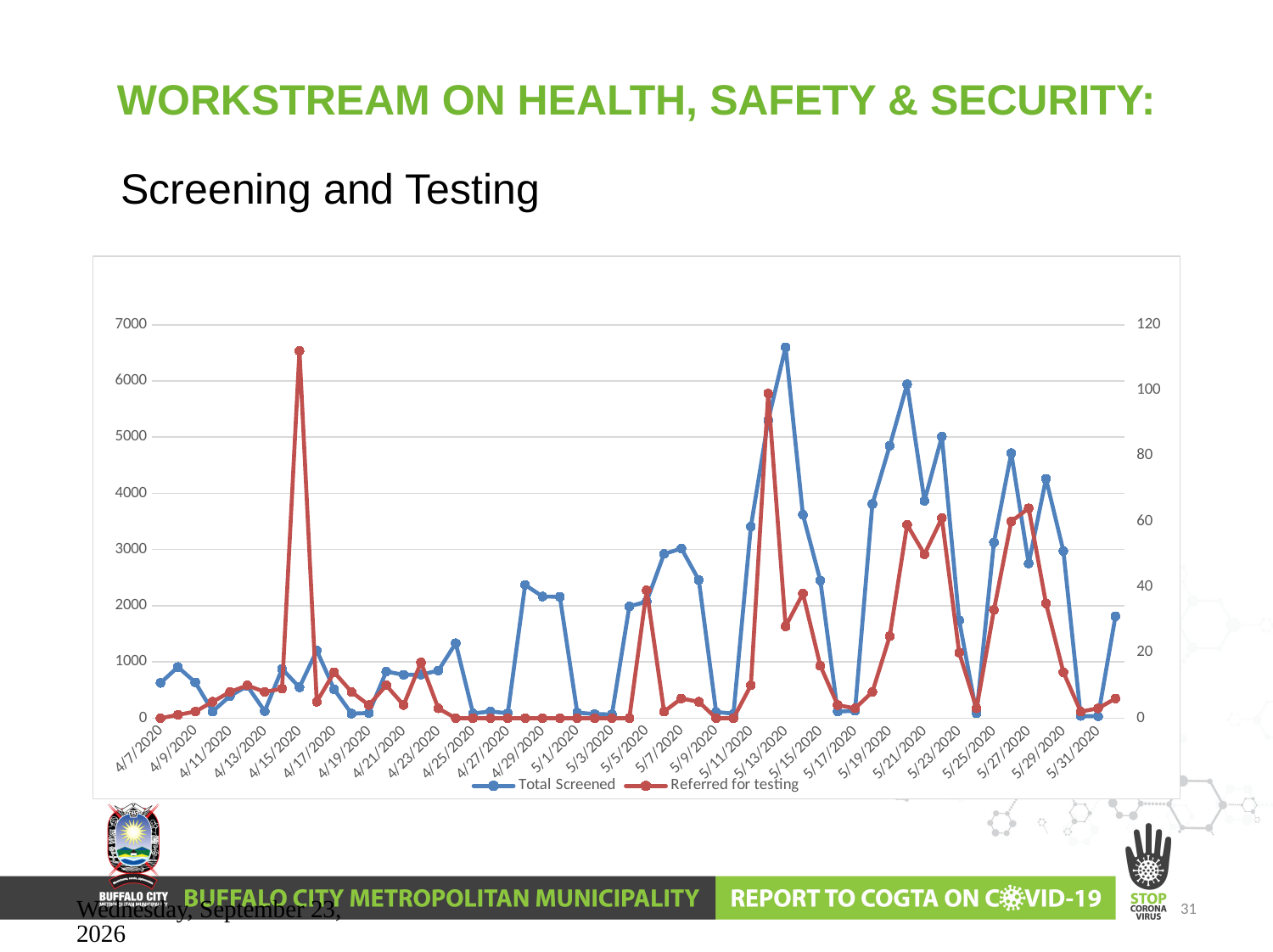
Does the Total Screened line rise or fall between 5/17/2020 and 5/21/2020? Rise Which date has the larger Total Screened value, 5/13/2020 or 4/7/2020? 5/13/2020 How many series does the chart legend list? 2 On which date does the Referred for testing line reach its highest point? 4/15/2020 Is the Referred for testing value on 4/15/2020 greater or less than 100? greater Is the Total Screened value on 5/21/2020 greater or less than 5000? less Is the Total Screened value on 4/7/2020 greater or less than 1000? less What kind of chart is shown on the slide? Line chart On which date does the Total Screened line reach its highest point? 5/13/2020 Which colour is used for the Total Screened line? Blue What are the two series named in the chart legend? Total Screened and Referred for testing